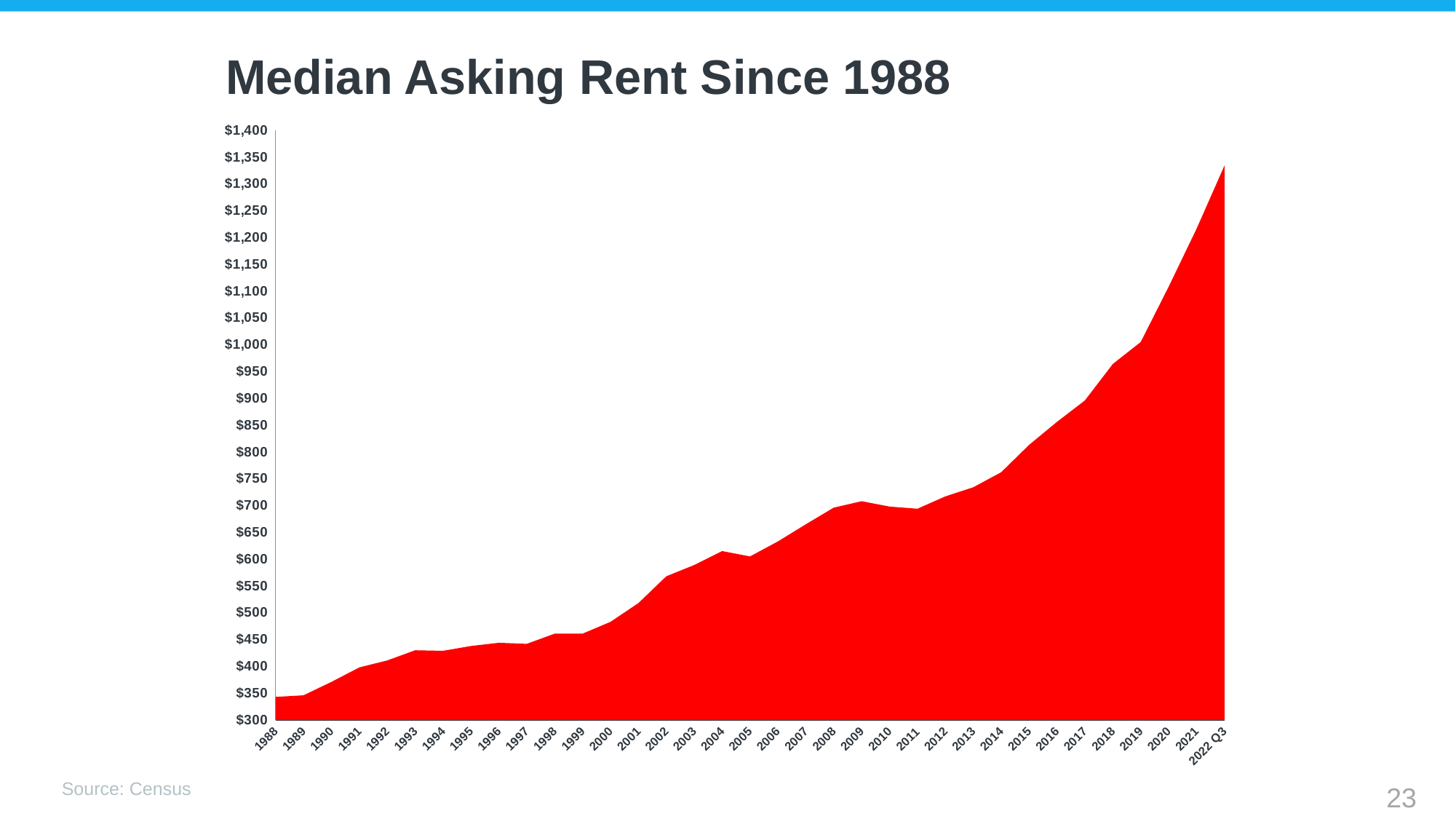
Is the value for 2006 greater or less than $600? greater Is the value for 2022 Q3 greater or less than $1,300? greater Is the value for 2013 greater or less than $700? greater Overall, do median asking rents rise or fall from 1988 to 2022 Q3? Rise Which is larger, the median asking rent in 2021 or in 2019? 2021 What kind of chart is shown on the slide? Area chart How many years or periods are shown on the x axis? 35 What is the title of the chart? Median Asking Rent Since 1988 Which year or period has the highest median asking rent? 2022 Q3